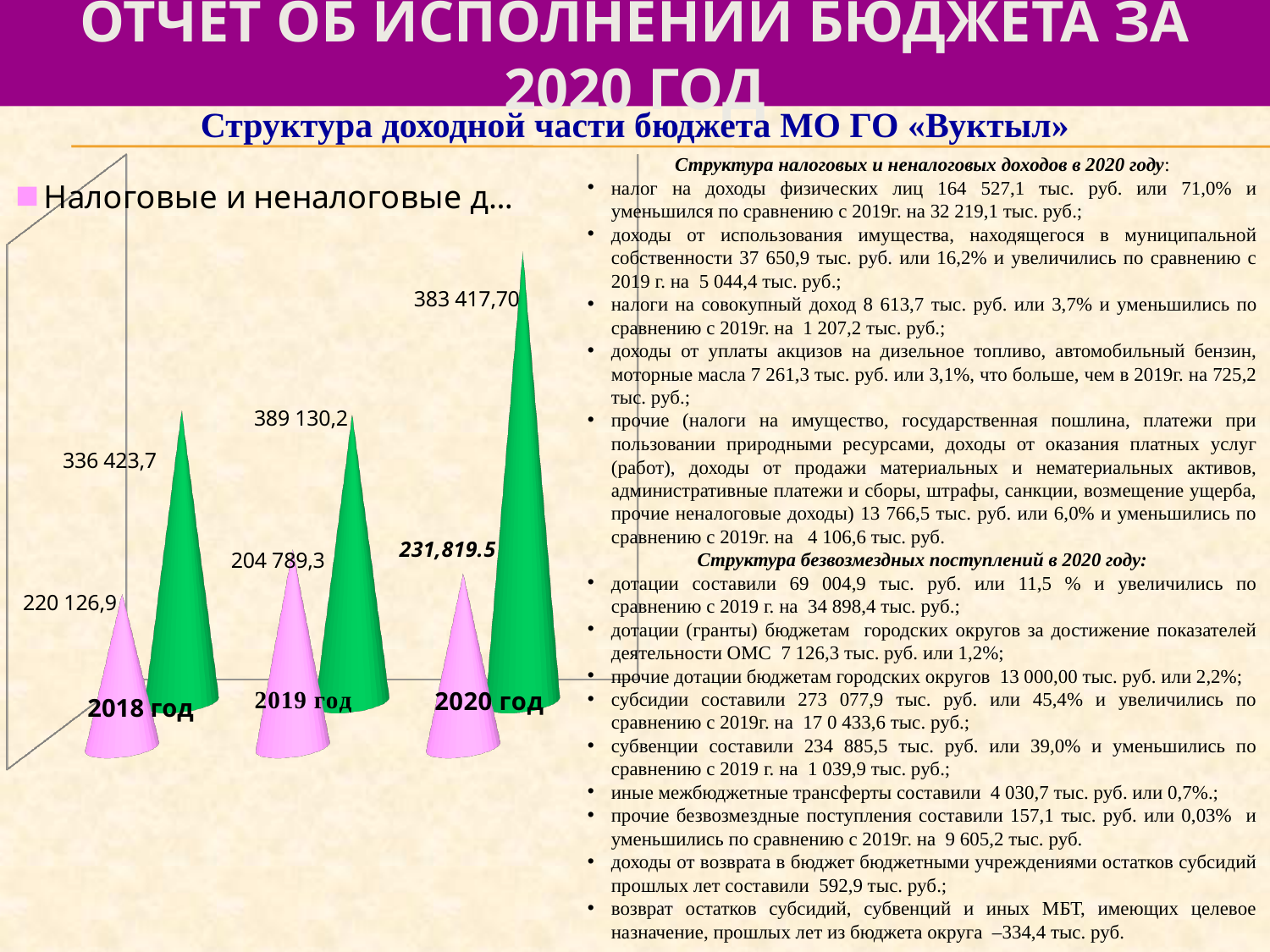
How many years (categories) are shown on the chart? 3 What is the value of the pink series (Налоговые и неналоговые д…) for 2019 год? 204 789,3 What is the value of the green series for 2020 год? 383 417,70 What is the value of the green series for 2019 год? 389 130,2 What is the value of the green series for 2018 год? 336 423,7 What type of chart is shown on the slide? bar chart What is the value of the pink series (Налоговые и неналоговые д…) for 2020 год? 231,819.5 For 2018 год, which is larger: the pink series or the green series? the green series What is the difference between the green series values for 2019 год and 2018 год? 52 706,5 What is the value of the pink series (Налоговые и неналоговые д…) for 2018 год? 220 126,9